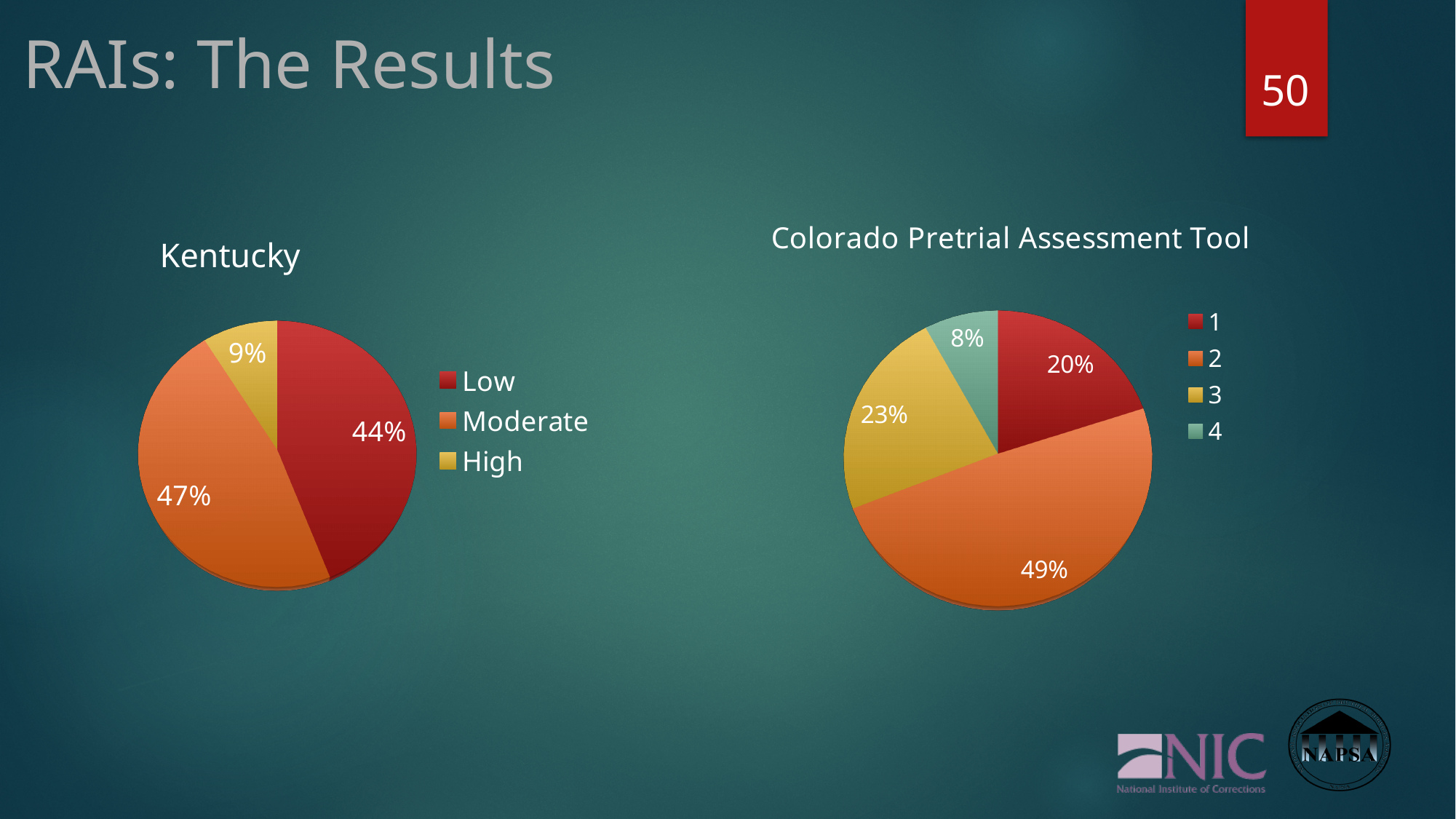
In the Kentucky chart, which category has the smallest slice? High In the Kentucky chart, what share is labelled Moderate? 47% What kind of chart is the Kentucky chart? Pie chart In the Colorado Pretrial Assessment Tool chart, how many categories does the legend list? 4 In the Colorado Pretrial Assessment Tool chart, what is the difference between the shares for category 3 and category 1? 3% In the Kentucky chart, what is the difference between the Moderate and Low shares? 3% In the Colorado Pretrial Assessment Tool chart, what share is labelled for category 4? 8% In the Colorado Pretrial Assessment Tool chart, which category has the largest slice? 2 In the Kentucky chart, what share is labelled High? 9% In the Colorado Pretrial Assessment Tool chart, which is larger, category 1 or category 3? 3 In the Colorado Pretrial Assessment Tool chart, what share is labelled for category 2? 49% In the Kentucky chart, how many categories does the legend list? 3